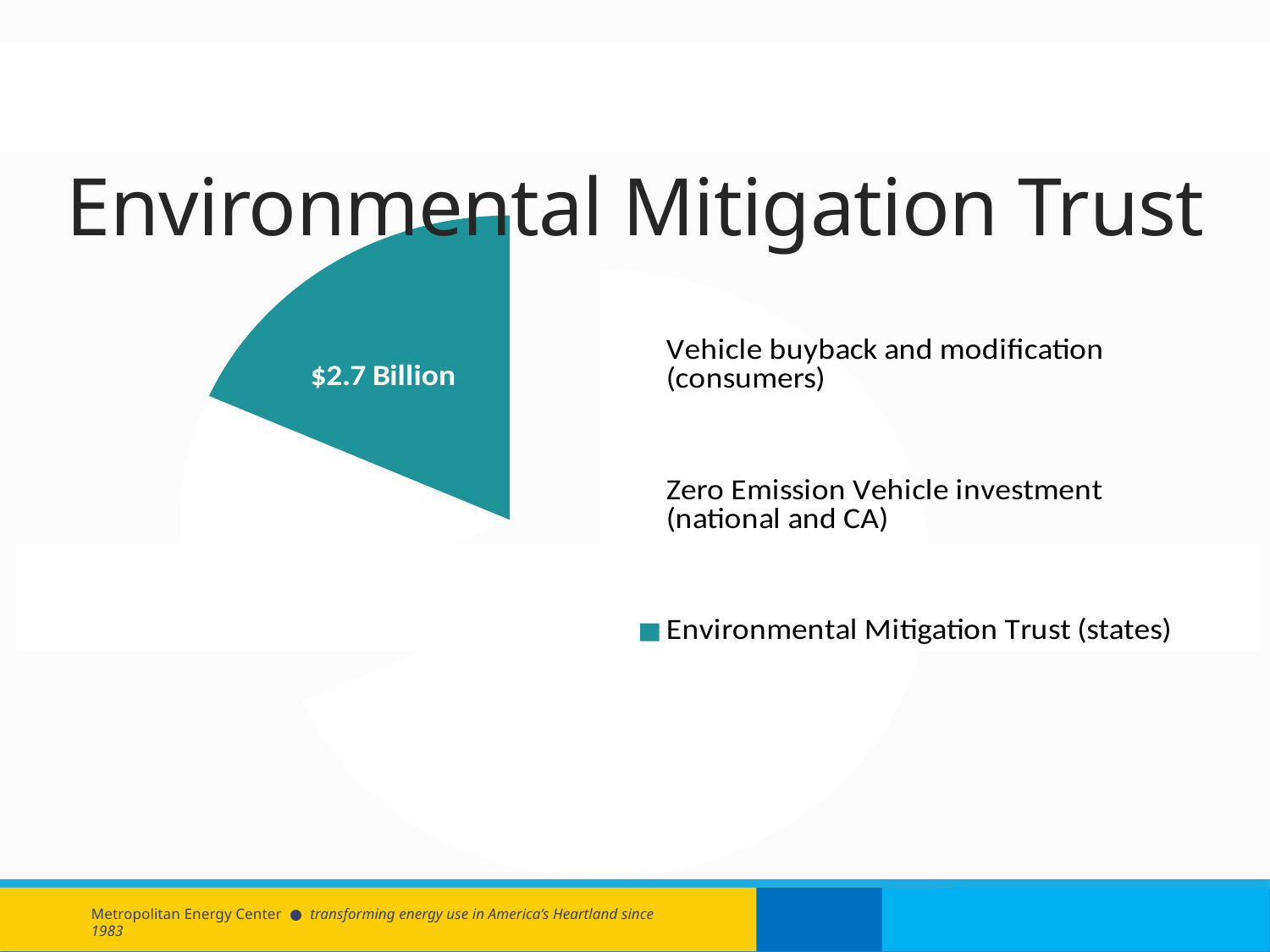
What colour is the slice for Environmental Mitigation Trust (states)? teal What is the title of the slide containing the pie chart? Environmental Mitigation Trust How many entries does the legend of the pie chart list? 3 What value is printed on the teal slice of the pie chart? $2.7 Billion What kind of chart is shown on the slide? pie chart Which legend entry does the teal slice labelled $2.7 Billion correspond to? Environmental Mitigation Trust (states)